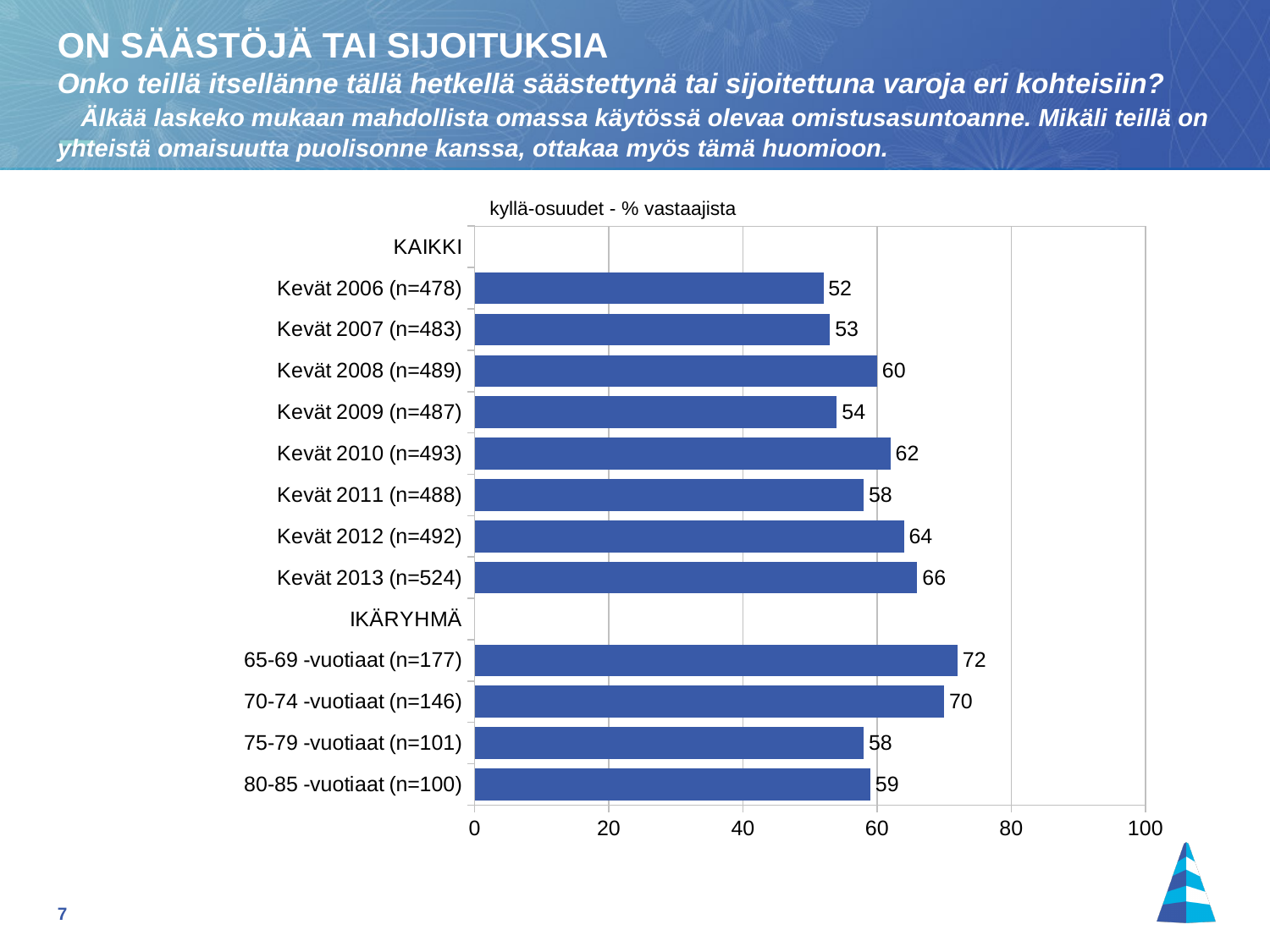
What is the value for 70-74 -vuotiaat (n=146)? 70 Which category has the highest value? 65-69 -vuotiaat (n=177) What is the difference between the values for Kevät 2013 (n=524) and Kevät 2006 (n=478)? 14 Is the value for 75-79 -vuotiaat (n=101) greater or less than 60? less How many bars are plotted on the chart? 12 What kind of chart is shown on the slide? bar chart Which is larger, the value for Kevät 2010 (n=493) or Kevät 2011 (n=488)? Kevät 2010 (n=493) What is the value for Kevät 2009 (n=487)? 54 What is the value for Kevät 2013 (n=524)? 66 Do the values for the Kevät 2006 to Kevät 2013 bars generally rise or fall over the years? rise Which category has the lowest value? Kevät 2006 (n=478) What is the title of the chart? kyllä-osuudet - % vastaajista